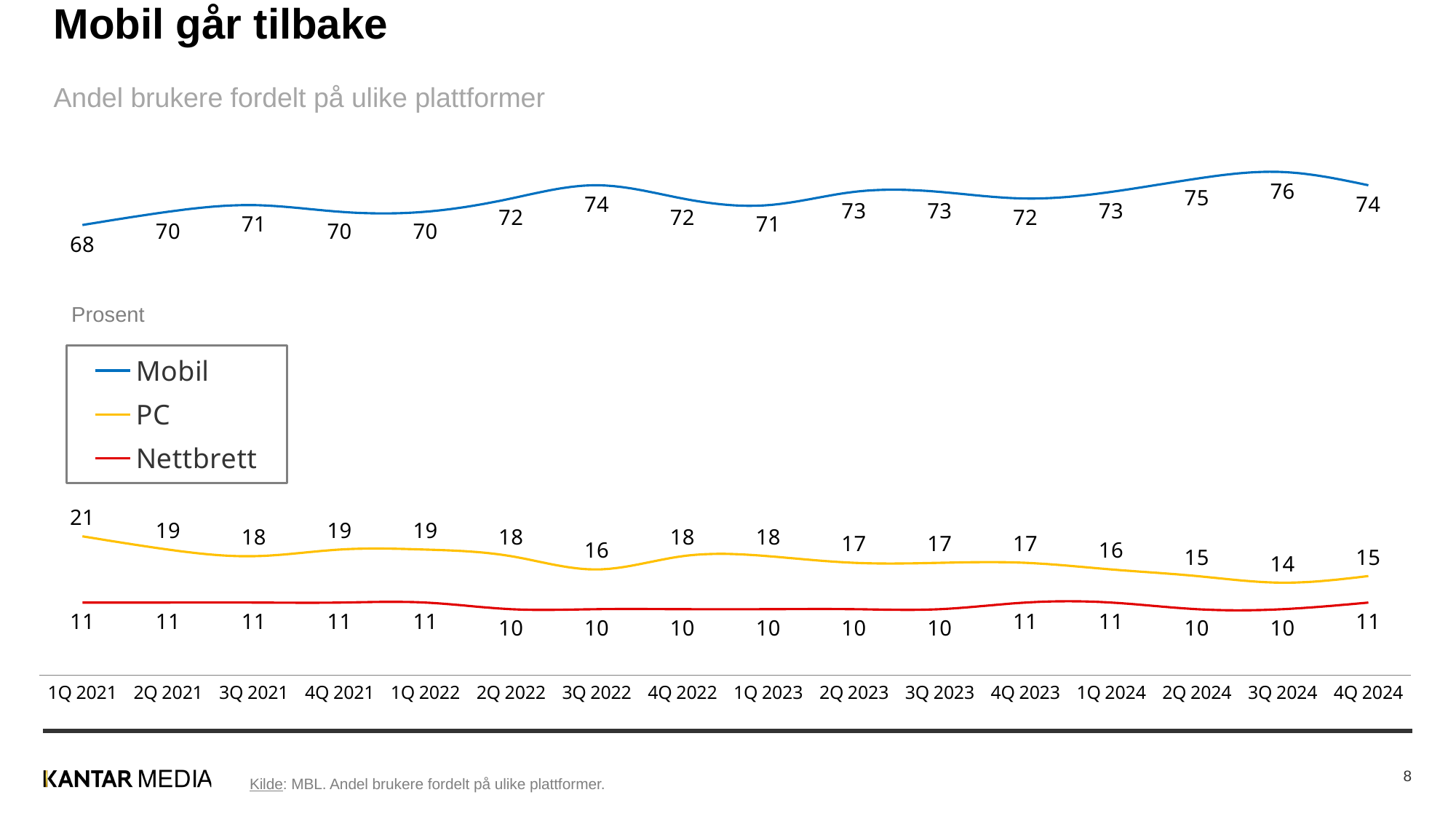
What is the value for Nettbrett in 4Q 2024? 11 Which series has the higher value in 3Q 2022, PC or Nettbrett? PC In which quarter does the PC series reach its lowest value? 3Q 2024 What is the value for Mobil in 3Q 2024? 76 How many quarters are shown on the x axis? 16 What is the difference between the PC value and the Nettbrett value in 1Q 2021? 10 How many series does the legend list? 3 In which quarter does the Mobil series reach its highest value? 3Q 2024 What kind of chart is shown on the slide? Line chart Does the PC series generally rise or fall from 1Q 2021 to 4Q 2024? Fall What is the value for PC in 1Q 2021? 21 What is the difference between the Mobil value in 4Q 2024 and the Mobil value in 1Q 2021? 6